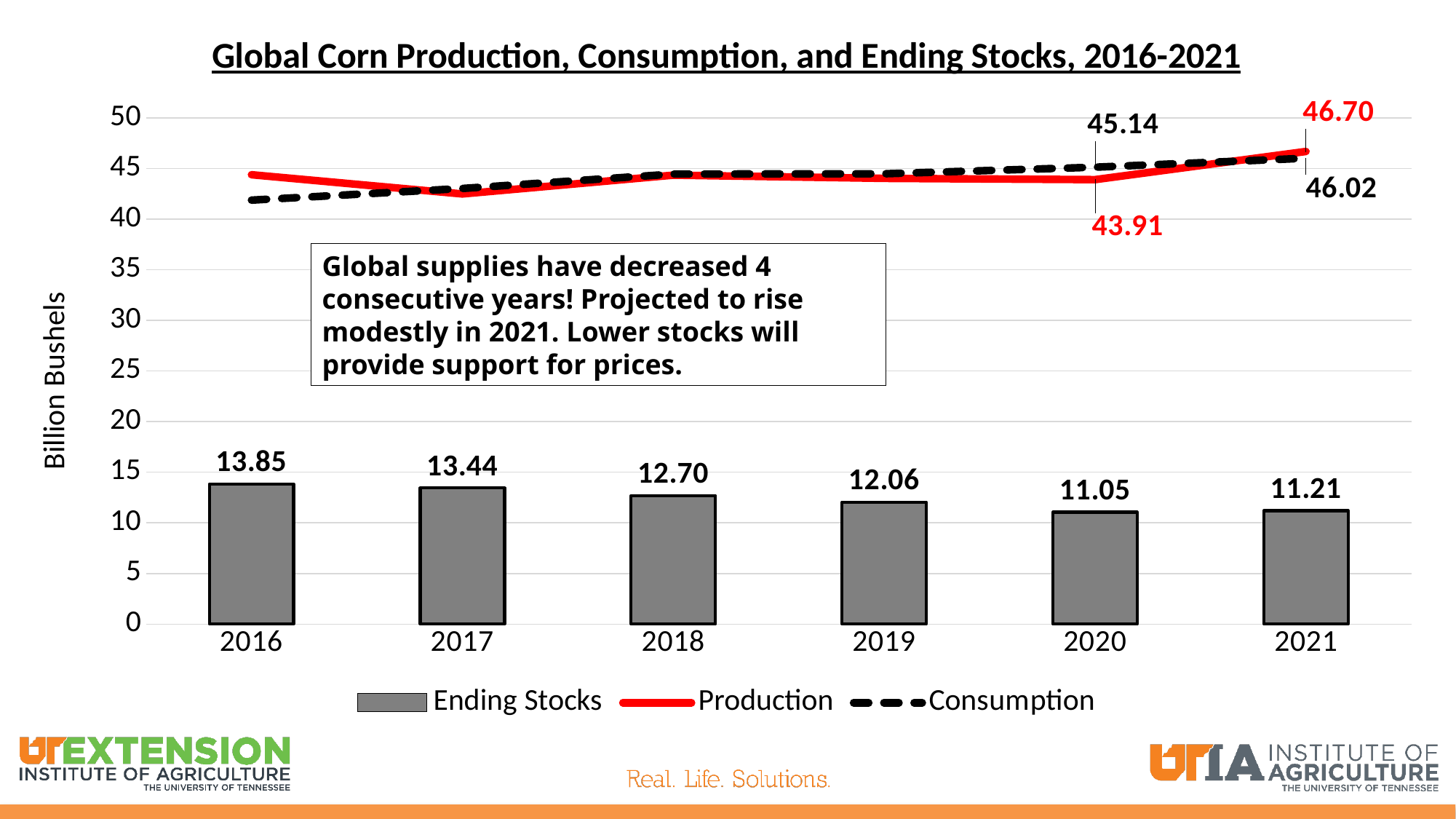
What is the Production value for 2021? 46.70 Which year has the highest Ending Stocks? 2016 How many series does the legend list? 3 What is the Consumption value for 2020? 45.14 In 2020, which is larger, Production or Consumption? Consumption Which year has the lowest Ending Stocks? 2020 How many years are shown on the x axis? 6 What is the value of Ending Stocks for 2016? 13.85 Is the Production value for 2016 greater or less than 40? greater What is the difference between Ending Stocks in 2016 and 2021? 2.64 What is the value of Ending Stocks for 2019? 12.06 Do the Ending Stocks values rise or fall from 2016 to 2020? fall